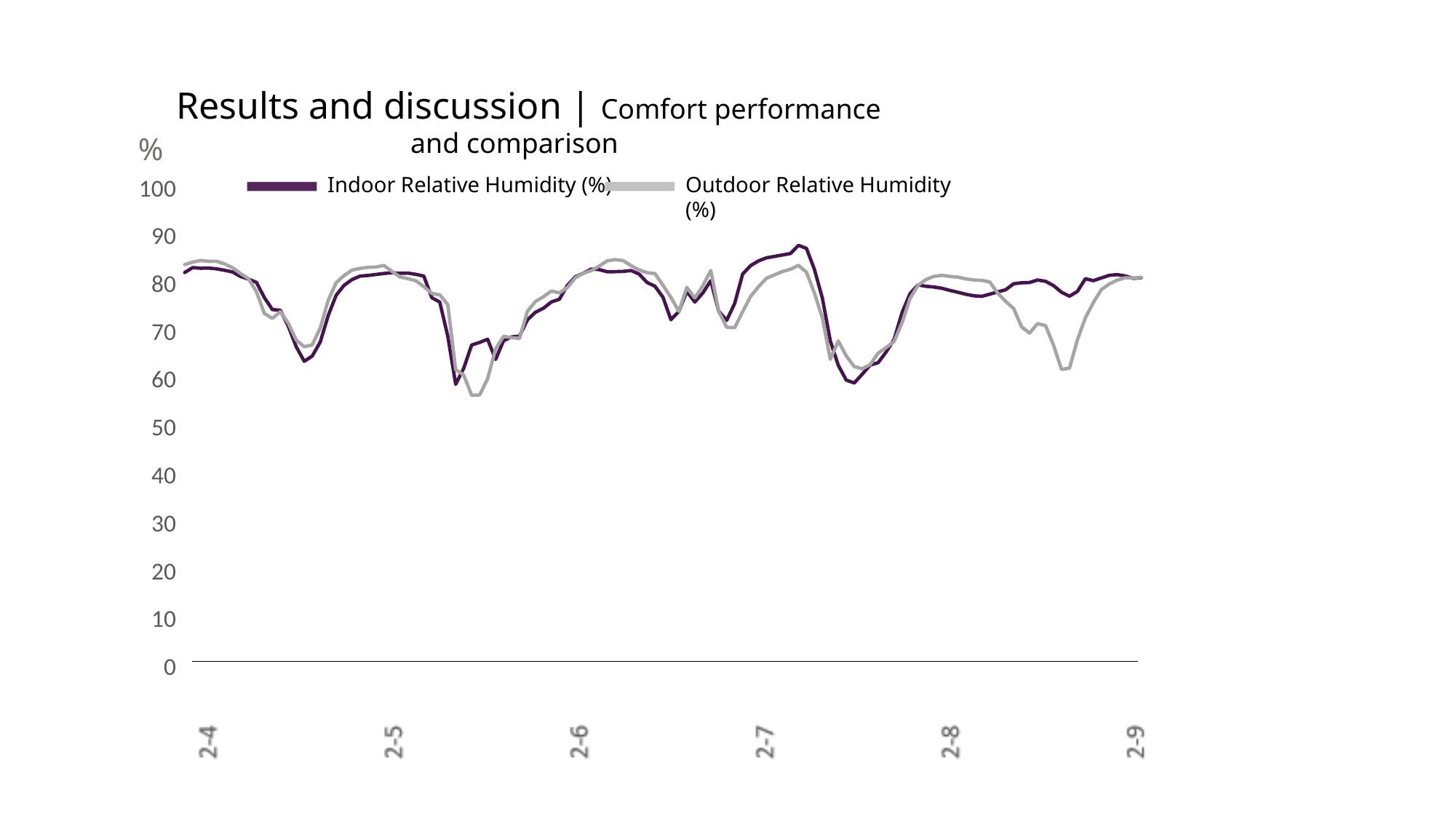
What kind of chart is shown on the slide? line chart Which colour is used for the Indoor Relative Humidity (%) line? purple What is the last date label on the x axis? 2-9 Is the Indoor Relative Humidity value at 2-8 greater or less than 70? greater Is the Indoor Relative Humidity value at 2-4 greater or less than 70? greater How many series does the legend list? 2 What are the two series named in the legend? Indoor Relative Humidity (%) and Outdoor Relative Humidity (%) Is the Outdoor Relative Humidity value at 2-9 greater or less than 60? greater What is the first date label on the x axis? 2-4 How many date labels are shown on the x axis? 6